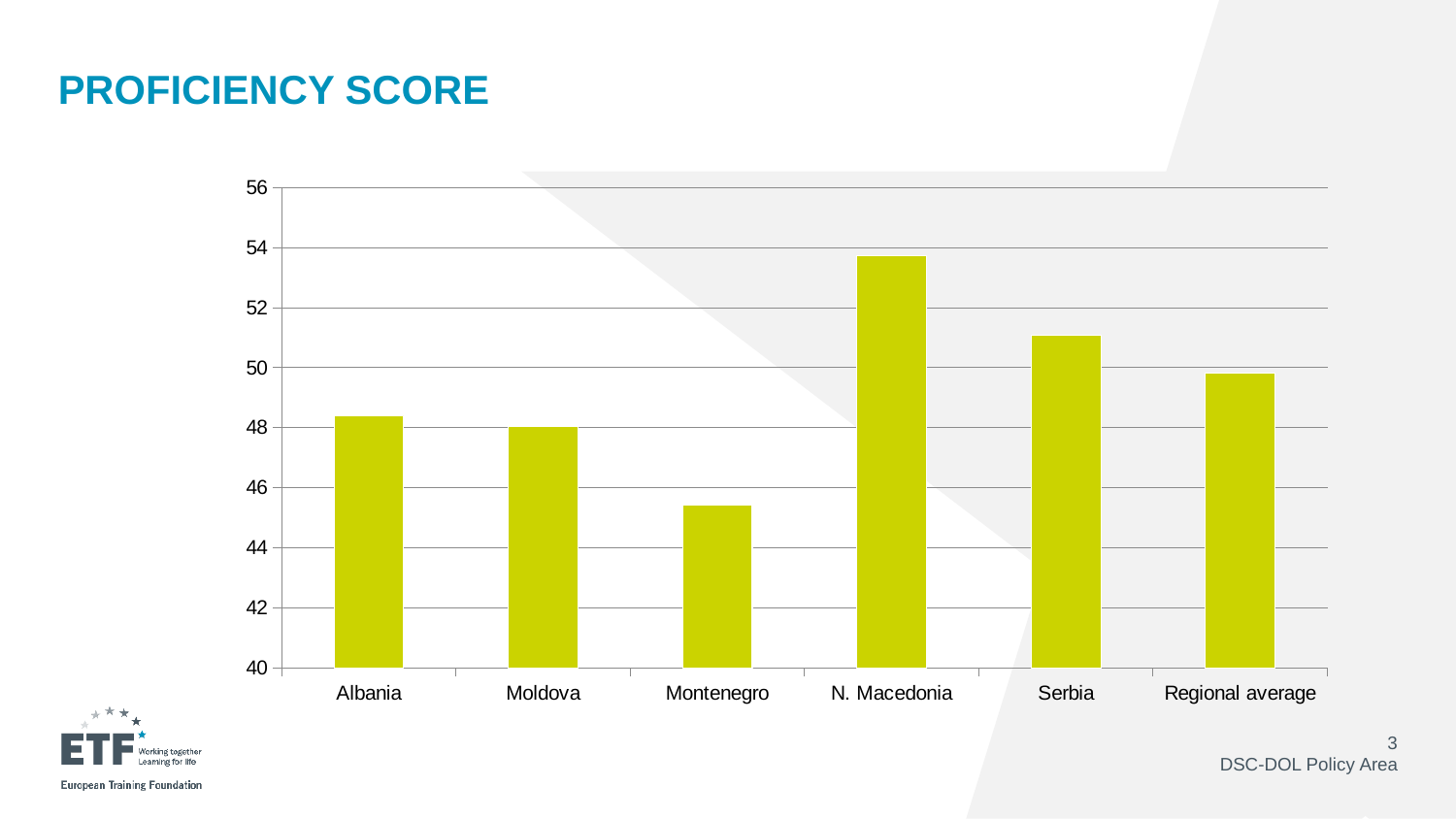
Is the value for Serbia greater or less than 50? greater What is the title of the slide containing the chart? PROFICIENCY SCORE Is the value for N. Macedonia greater or less than 52? greater How many categories are shown on the x axis of the chart? 6 Which category has the highest bar in the chart? N. Macedonia Which is larger, the value for Montenegro or the value for Albania? Albania Which category has the lowest bar in the chart? Montenegro Is the value for Montenegro greater or less than 46? less Which is larger, the value for N. Macedonia or the value for Serbia? N. Macedonia Which is larger, the value for Serbia or the value for Regional average? Serbia What kind of chart is shown on the slide? bar chart